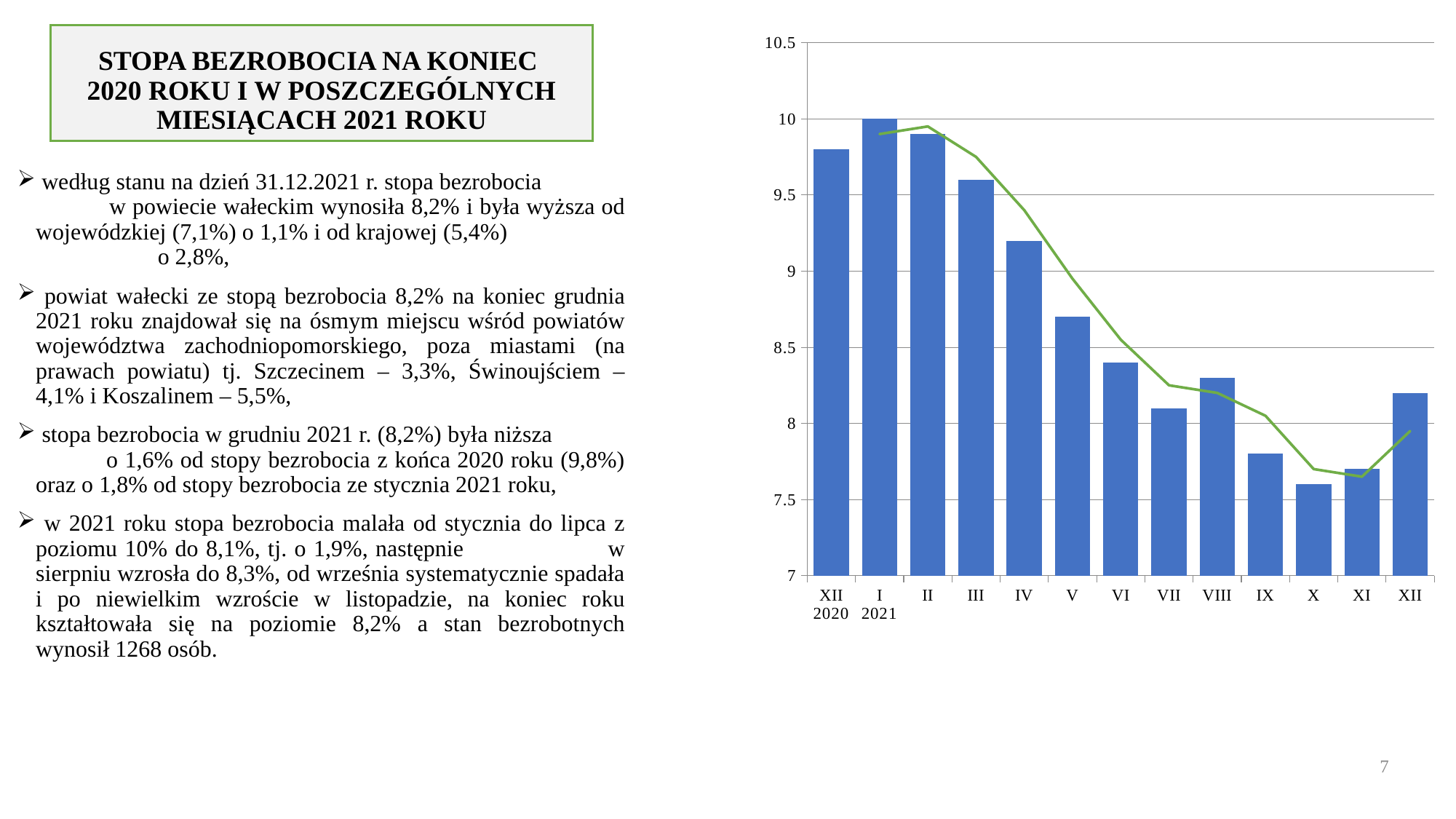
Which month has the highest bar on the chart? I 2021 Which bar is taller, XII 2020 or XII 2021? XII 2020 Do the bars rise or fall from I to VII? fall How many bars (months) are plotted on the chart? 13 Is the value for IV greater or less than 9.5? less Is the value for IX greater or less than 8? less Is the value for V greater or less than 9? less What value does the bar for I 2021 reach on the axis? 10 Which month has the lowest bar on the chart? X What kind of chart is shown on the slide? bar chart